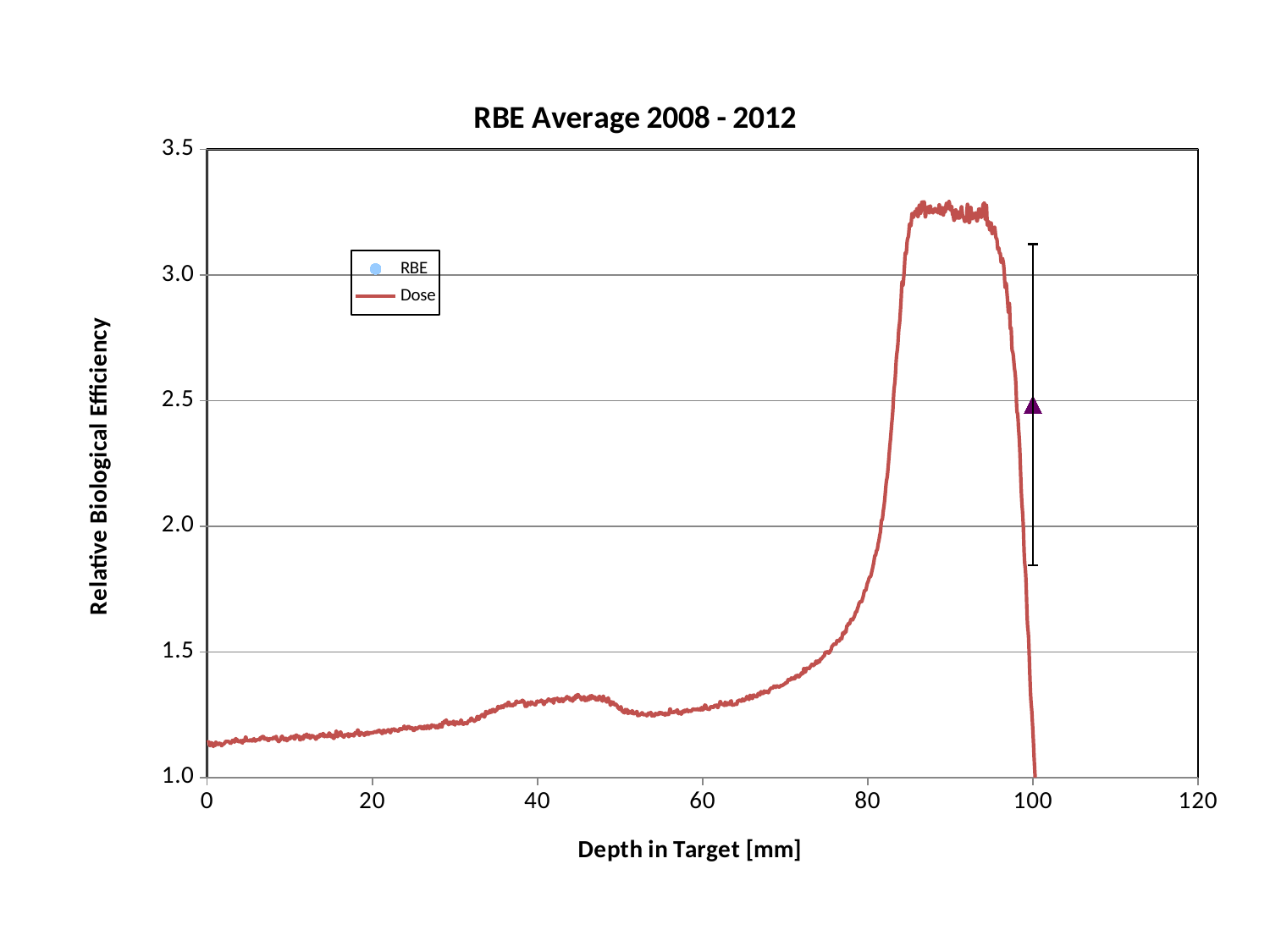
Is the RBE point plotted at a depth of 100 mm greater or less than 3.0? less What type of chart is shown on the slide? line chart Is the Dose value at a depth of 80 mm greater or less than 2.0? less Is the Dose value at a depth of 60 mm greater or less than 1.5? less Does the Dose curve rise or fall between depths of 0 mm and 40 mm? rise What is the label of the x axis? Depth in Target [mm] How many RBE data points are plotted on the chart? 1 How many series does the chart legend list? 2 What is the title of the chart? RBE Average 2008 - 2012